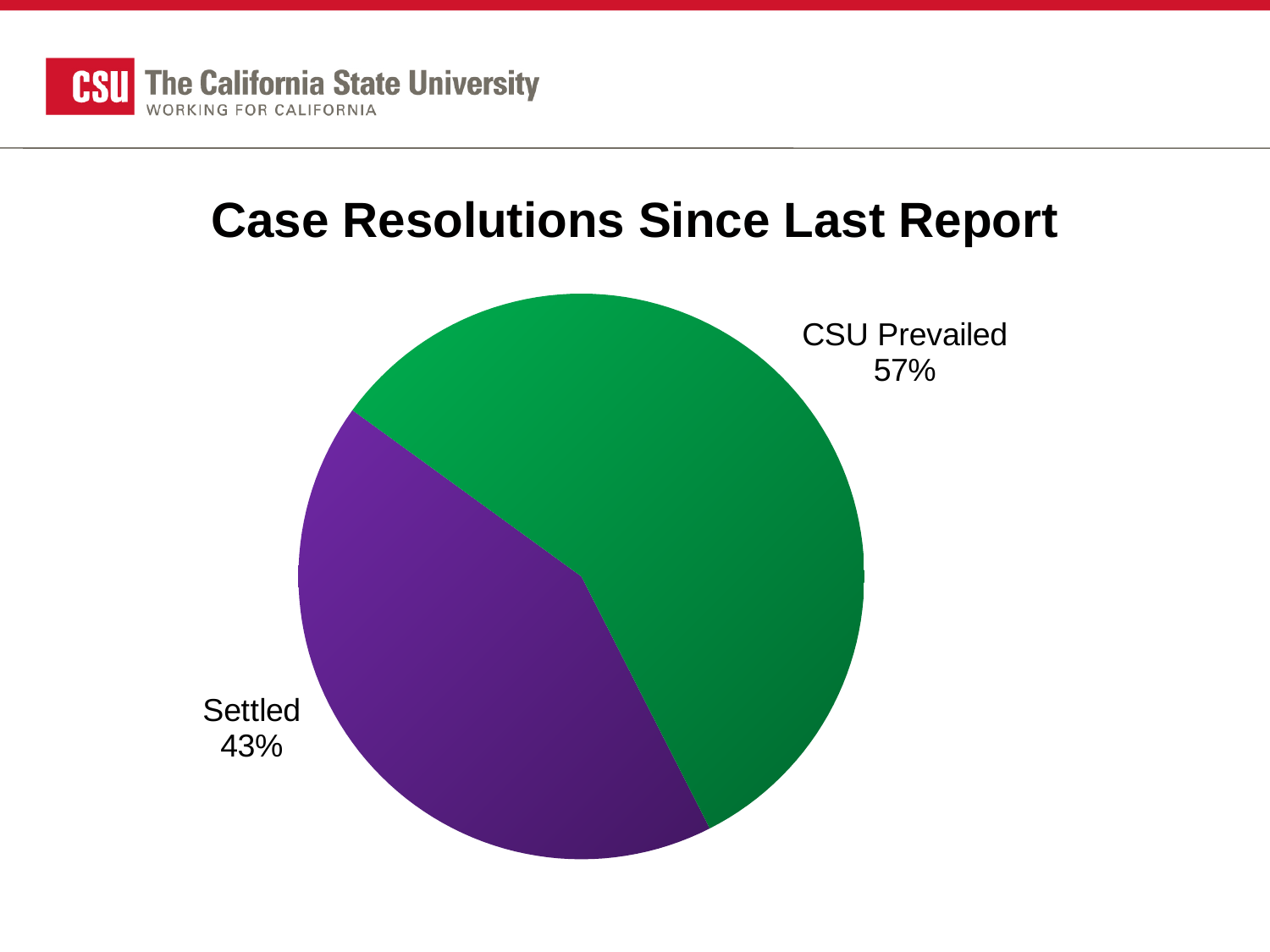
What is the title of the chart? Case Resolutions Since Last Report Is the share for CSU Prevailed greater or less than 50%? greater What kind of chart is shown on the slide? pie chart What is the difference in percentage points between the CSU Prevailed and Settled slices? 14 What colour is the Settled slice? purple How many slices does the pie chart have? 2 Which slice of the pie is the largest? CSU Prevailed What share of case resolutions is labelled CSU Prevailed? 57% Which is larger, the CSU Prevailed slice or the Settled slice? CSU Prevailed Is the share for Settled greater or less than 50%? less Which slice of the pie is the smallest? Settled What share of case resolutions is labelled Settled? 43%